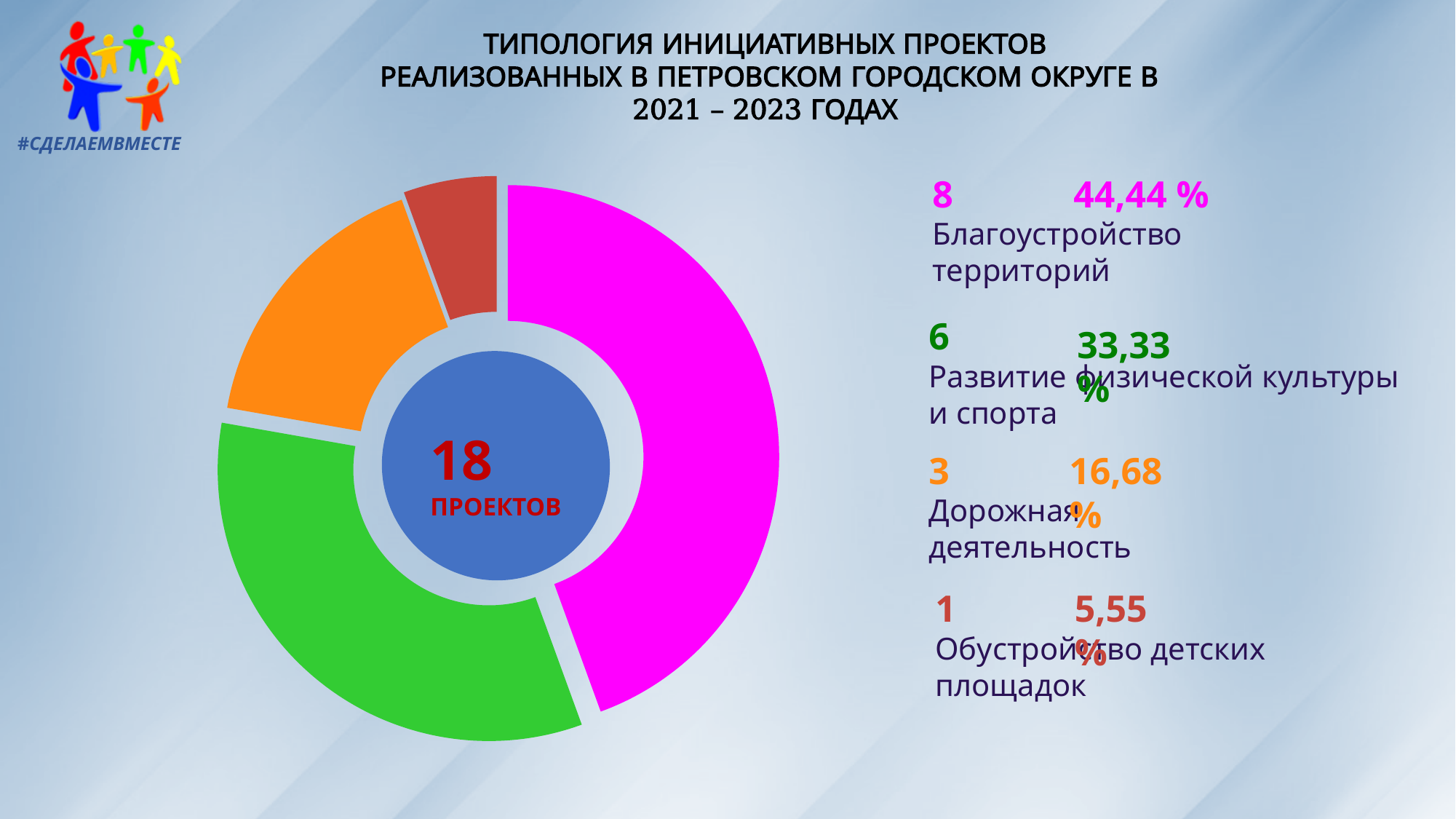
What is the total number of projects shown in the centre of the chart? 18 What percentage share is shown for "Развитие физической культуры и спорта"? 33,33 % How many projects are in the category "Дорожная деятельность"? 3 Which category has the smallest number of projects? Обустройство детских площадок What kind of chart is shown on the slide? Donut (pie) chart How many categories does the chart show? 4 Which category has the largest number of projects? Благоустройство территорий What percentage share is shown for "Обустройство детских площадок"? 5,55 % What is the difference in the number of projects between "Благоустройство территорий" and "Развитие физической культуры и спорта"? 2 How many projects are in the category "Благоустройство территорий"? 8 What colour is the segment for "Благоустройство территорий"? Magenta (pink) Which has more projects: "Дорожная деятельность" or "Обустройство детских площадок"? Дорожная деятельность